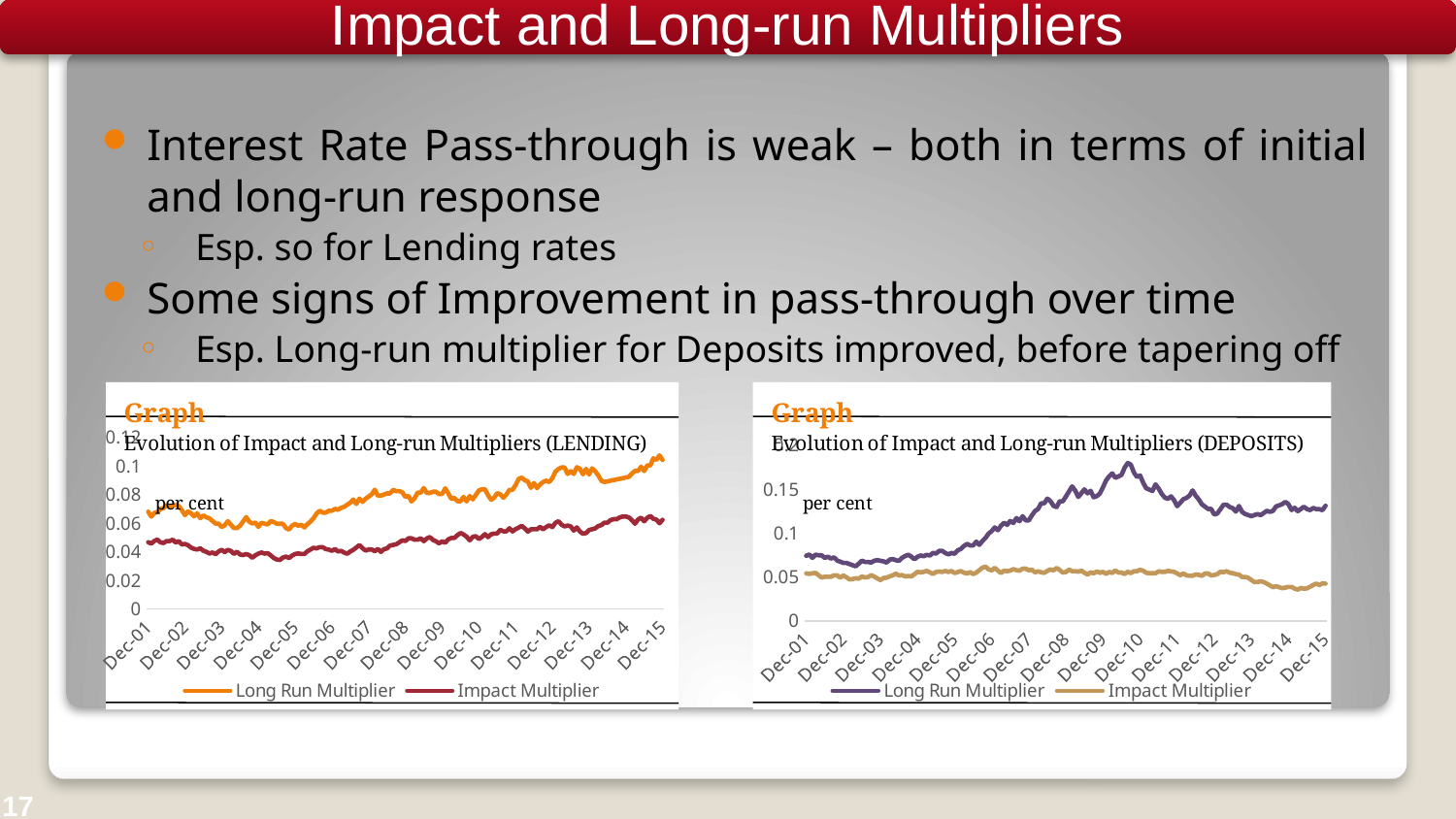
In the LENDING chart, does the Long Run Multiplier overall rise or fall from Dec-01 to Dec-15? rise In the LENDING chart, is the Impact Multiplier at Dec-01 greater or less than 0.06? less How many series does the legend of the LENDING chart list? 2 How many Dec-labelled tick marks are on the x axis of the LENDING chart? 15 In the DEPOSITS chart, is the Long Run Multiplier at its peak around Dec-10 greater or less than 0.15? greater In the LENDING chart, is the Long Run Multiplier at Dec-15 greater or less than 0.08? greater In the LENDING chart, which series is higher throughout the period, Long Run Multiplier or Impact Multiplier? Long Run Multiplier In the DEPOSITS chart, which series is higher at Dec-15, Long Run Multiplier or Impact Multiplier? Long Run Multiplier What type of chart is the Evolution of Impact and Long-run Multipliers (LENDING) chart? line chart What is the highest value shown on the y axis of the DEPOSITS chart? 0.2 What unit label is shown on the DEPOSITS chart's y axis? per cent